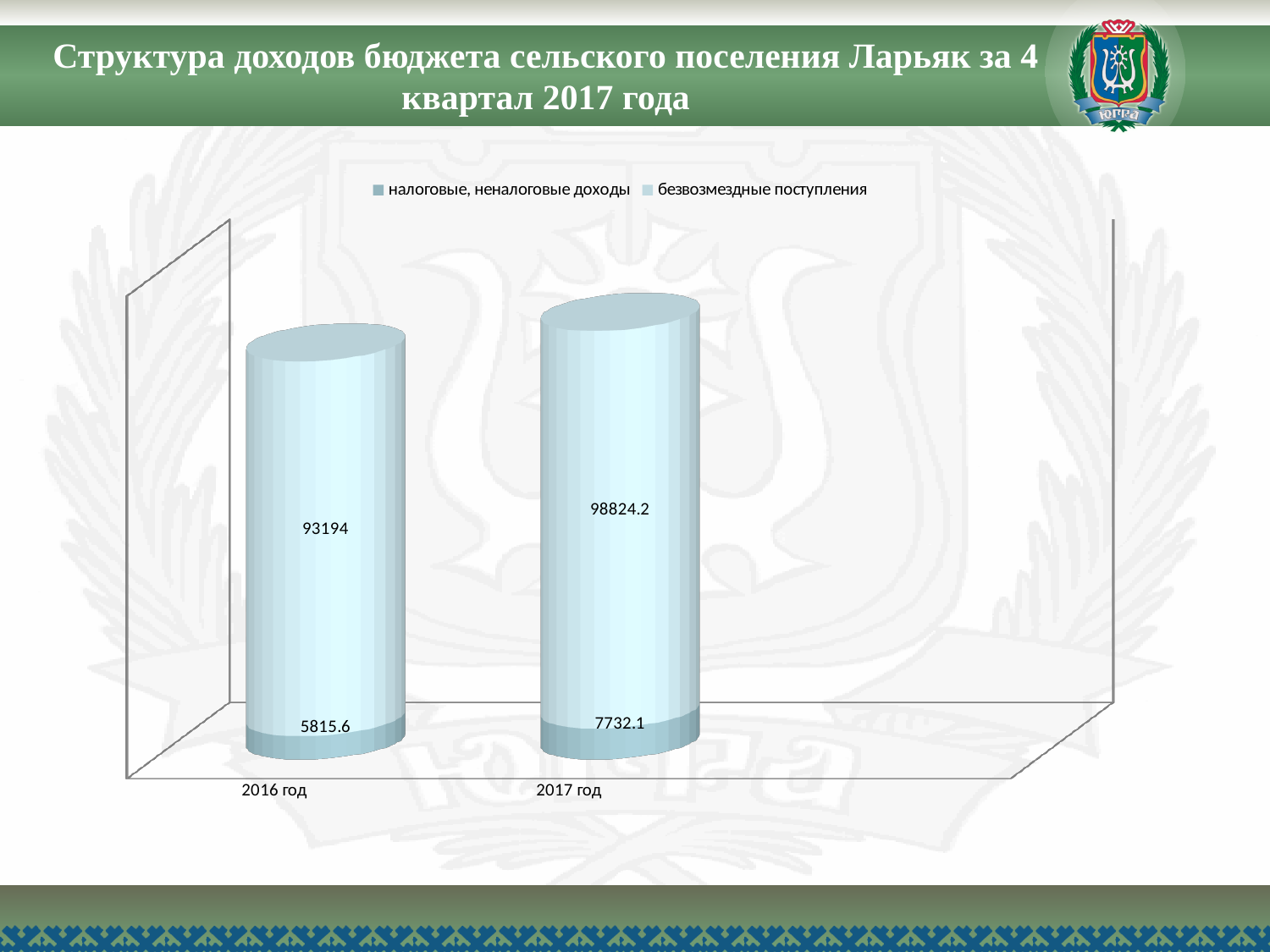
What is the total of the stacked bar for 2017 год? 106556.3 What is the value of налоговые, неналоговые доходы for 2016 год? 5815.6 How many series does the legend list? 2 Which year has the lower value for налоговые, неналоговые доходы? 2016 год What is the value of безвозмездные поступления for 2016 год? 93194 What kind of chart is shown on the slide? Stacked bar chart Which year has the higher value for безвозмездные поступления? 2017 год What is the difference between налоговые, неналоговые доходы in 2017 год and 2016 год? 1916.5 What is the total of the stacked bar for 2016 год? 99009.6 What is the value of налоговые, неналоговые доходы for 2017 год? 7732.1 What is the value of безвозмездные поступления for 2017 год? 98824.2 What is the difference between безвозмездные поступления in 2017 год and 2016 год? 5630.2